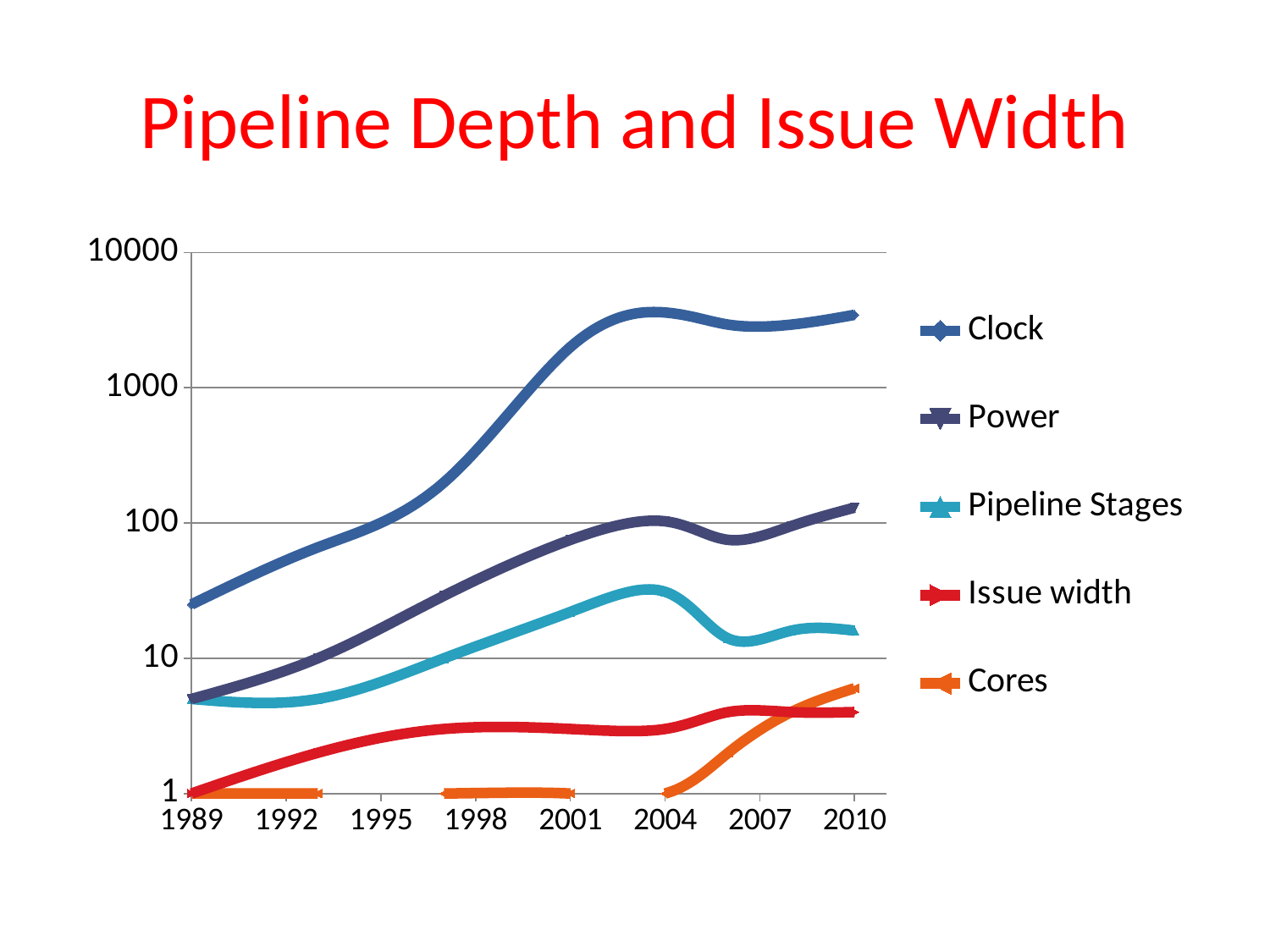
What kind of chart is shown on the slide? line chart Does the Clock series rise or fall from 1989 to 2004? rise In 2010, which is larger: Cores or Issue width? Cores Is the value for Power in 1989 greater or less than 10? less Is the value for Issue width in 2007 greater or less than 10? less Which series has the highest value in 2010? Clock Is the value for Clock in 2010 greater or less than 1000? greater What is the title of the slide? Pipeline Depth and Issue Width Which series has the lowest value in 2001? Cores What is the value for Cores in 1989? 1 How many series does the legend list? 5